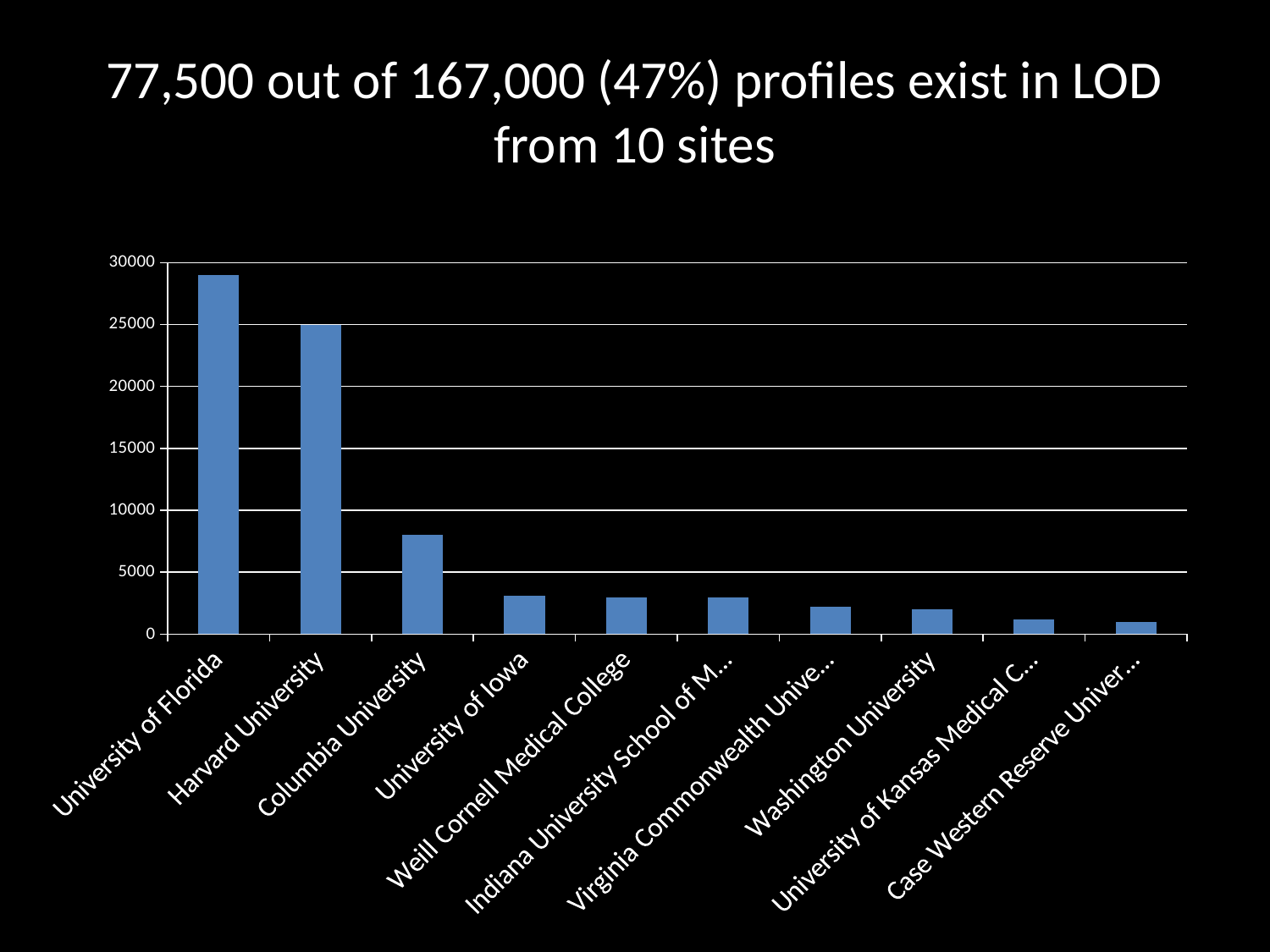
How many institutions (categories) are plotted in the chart? 10 Which is larger, the value for University of Florida or the value for Harvard University? University of Florida What kind of chart is shown on the slide? bar chart Is the value for University of Iowa greater or less than 5000? less Which institution has the highest bar in the chart? University of Florida Is the value for University of Florida greater or less than 25000? greater Which is larger, the value for Harvard University or the value for Columbia University? Harvard University Is the value for Columbia University greater or less than 5000? greater What is the title of the slide containing the chart? 77,500 out of 167,000 (47%) profiles exist in LOD from 10 sites Do the bar values rise or fall moving from left to right along the x axis? fall Which institution has the lowest bar in the chart? Case Western Reserve University